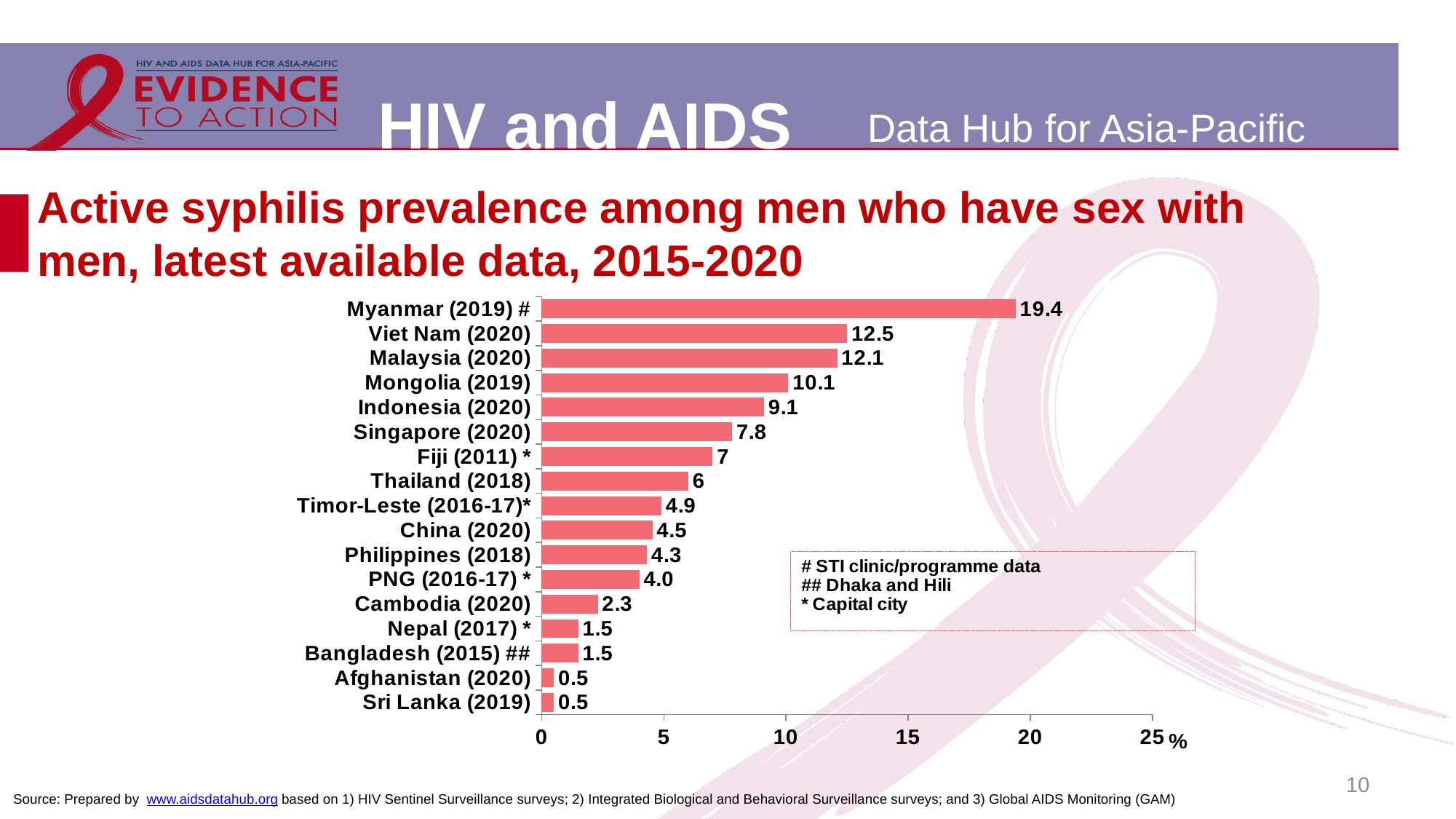
Is the value for Mongolia (2019) greater or less than 10? greater What is the difference between the values for Myanmar (2019) and Mongolia (2019)? 9.3 Which has a larger value, China (2020) or Philippines (2018)? China (2020) What value is shown for Indonesia (2020)? 9.1 What kind of chart is shown on the slide? Bar chart What value is shown for Cambodia (2020)? 2.3 What is the active syphilis prevalence value shown for Myanmar (2019)? 19.4 Which has a larger value, Singapore (2020) or Thailand (2018)? Singapore (2020) Which country has the highest active syphilis prevalence in the chart? Myanmar (2019) What is the difference between the values for Viet Nam (2020) and Malaysia (2020)? 0.4 How many countries are shown in the chart? 17 What is the maximum value shown on the x axis of the chart? 25